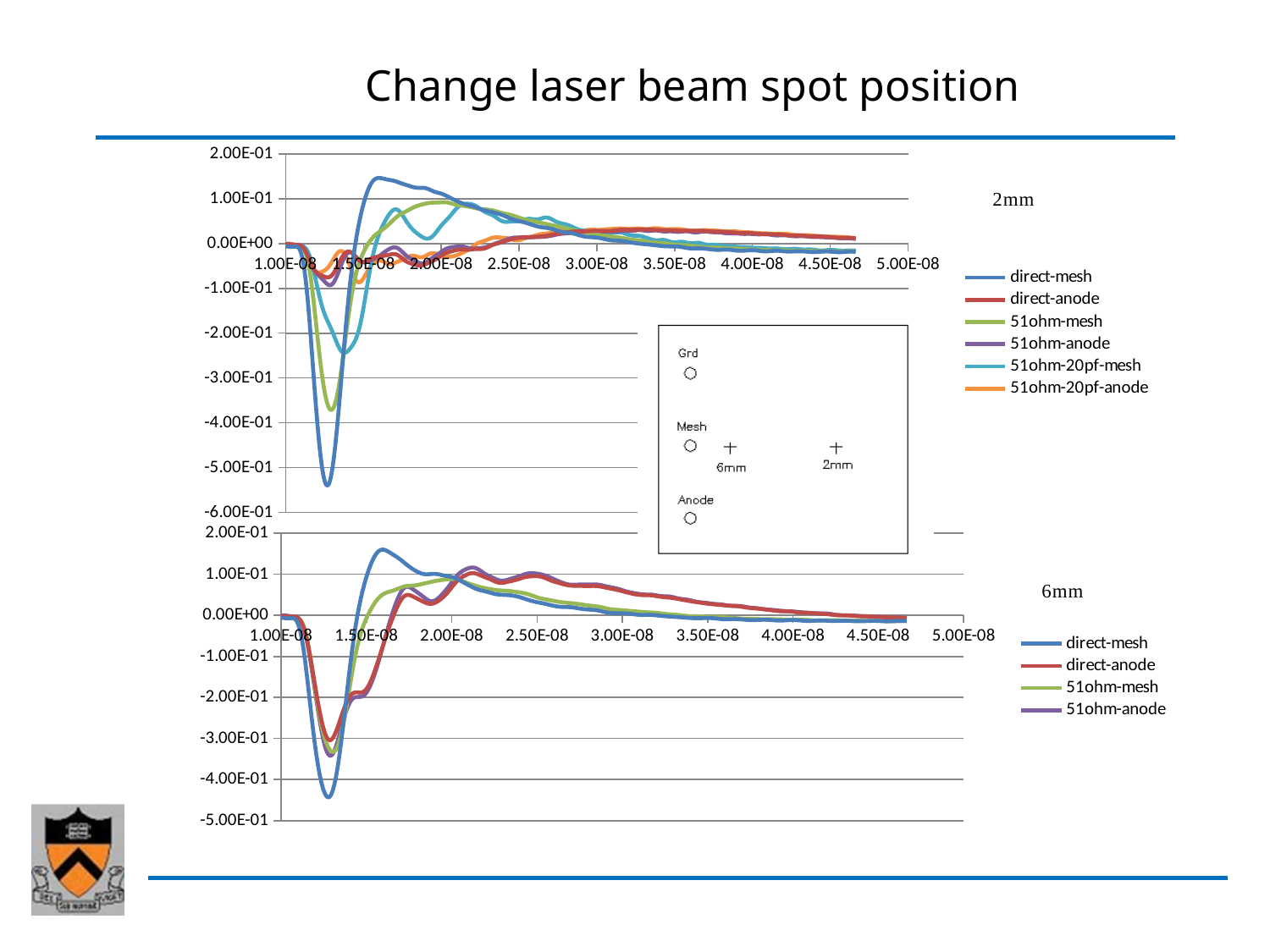
In the bottom (6mm) chart, which series reaches the lowest value? direct-mesh In the bottom (6mm) chart, is the minimum value of the direct-mesh series greater or less than -4.00E-01? less In the top (2mm) chart, is the minimum value of the direct-mesh series greater or less than -5.00E-01? less What is the title of the slide containing the two charts? Change laser beam spot position What is the lowest value shown on the y axis of the top (2mm) chart? -6.00E-01 How many series does the legend of the top (2mm) chart list? 6 What kind of chart is the top (2mm) chart? line chart In the top (2mm) chart, which series reaches the lowest value? direct-mesh How many series does the legend of the bottom (6mm) chart list? 4 In the top (2mm) chart, which series dips lower: 51ohm-mesh or 51ohm-20pf-mesh? 51ohm-mesh In the top (2mm) chart, is the peak value of the direct-mesh series greater or less than 1.00E-01? greater